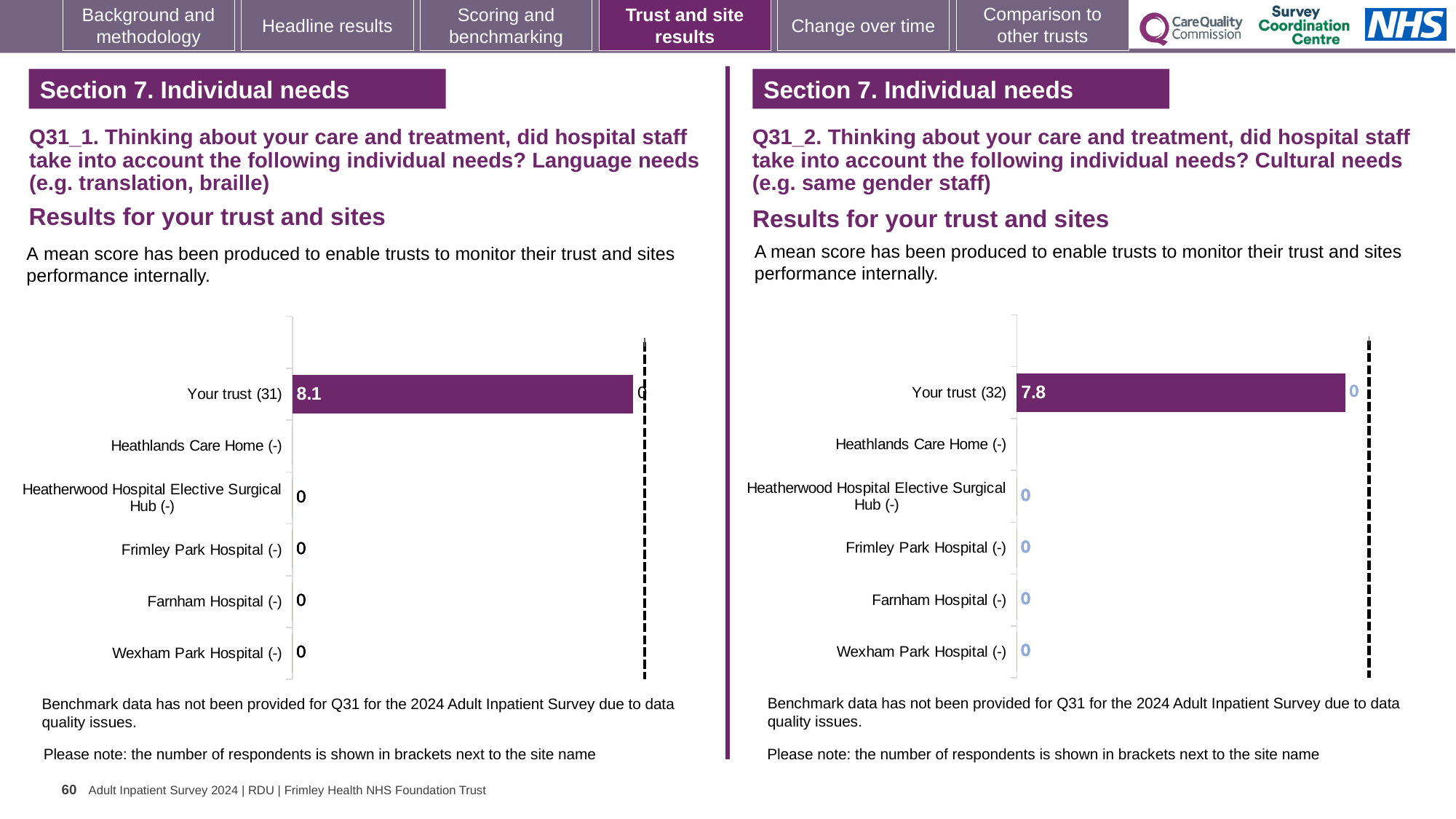
In the left chart (Q31_1, Language needs), what is the mean score for Your trust? 8.1 In the right chart (Q31_2, Cultural needs), how many respondents are shown in brackets for Your trust? 32 What kind of chart is the left chart (Q31_1, Language needs)? bar chart In the right chart (Q31_2, Cultural needs), which category has the highest score? Your trust (32) Which site is listed last (at the bottom) on the y axis of the left chart (Q31_1)? Wexham Park Hospital (-) In the right chart (Q31_2, Cultural needs), what is the mean score for Your trust? 7.8 In the left chart (Q31_1, Language needs), how many respondents are shown in brackets for Your trust? 31 Is the Your trust score in the left chart (Q31_1) larger or smaller than the Your trust score in the right chart (Q31_2)? larger What colour is the Your trust bar in the right chart (Q31_2, Cultural needs)? purple How many categories (sites) are listed on the y axis of the right chart (Q31_2, Cultural needs)? 6 In the left chart (Q31_1, Language needs), which category has the highest score? Your trust (31) What is the difference between the Your trust score in the left chart (Q31_1) and the Your trust score in the right chart (Q31_2)? 0.3